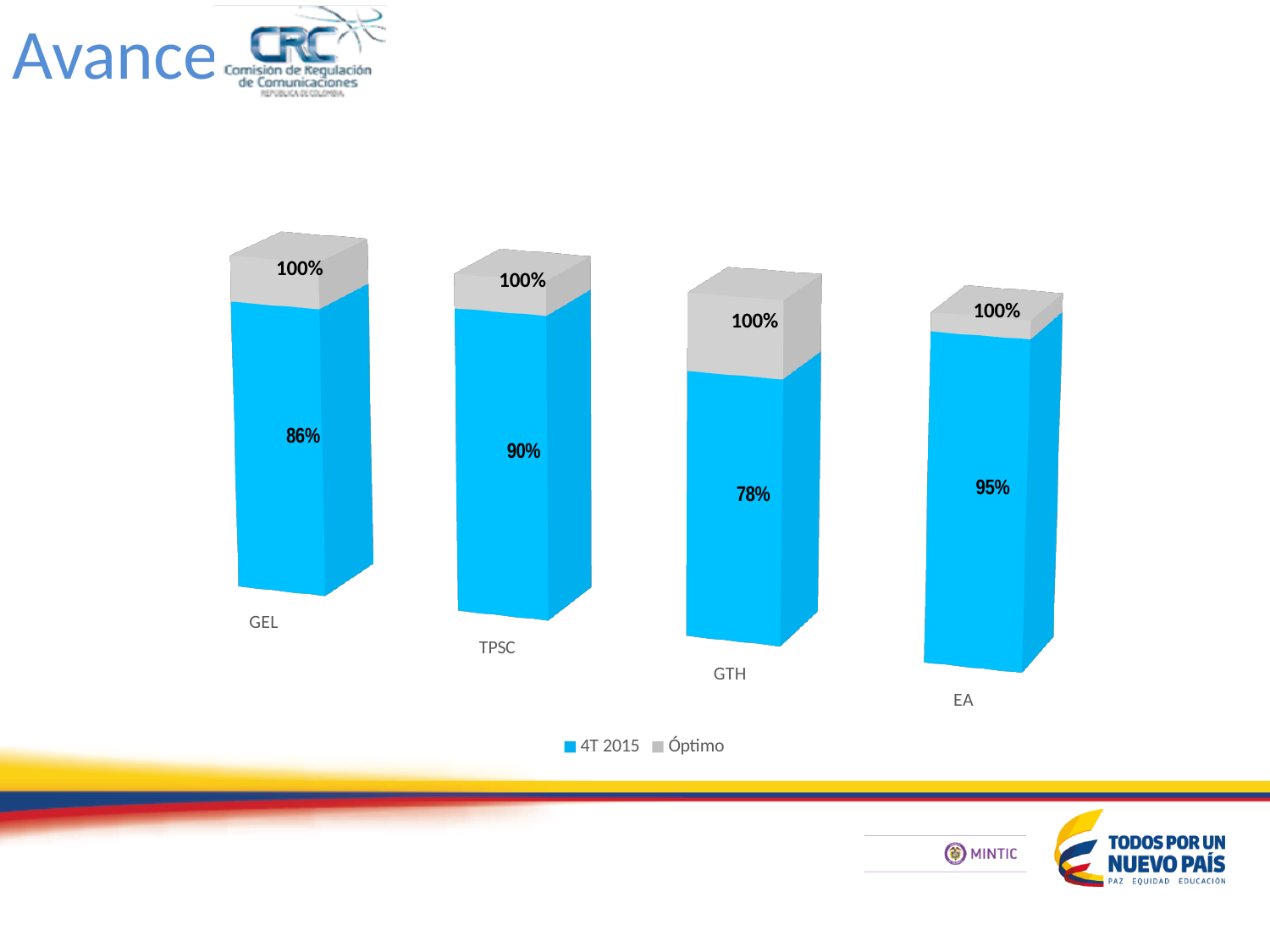
What is the 4T 2015 value for GTH? 78% What is the difference between the 4T 2015 values for EA and GTH? 17% What is the 4T 2015 value for EA? 95% How many categories are shown on the x axis? 4 Which category has the lowest 4T 2015 value? GTH What is the 4T 2015 value for GEL? 86% What is the 4T 2015 value for TPSC? 90% Which category has the highest 4T 2015 value? EA Which has a larger 4T 2015 value, GEL or TPSC? TPSC What kind of chart is shown on the slide? Stacked bar chart How many series does the legend list? 2 What is the Óptimo value shown for GTH? 100%